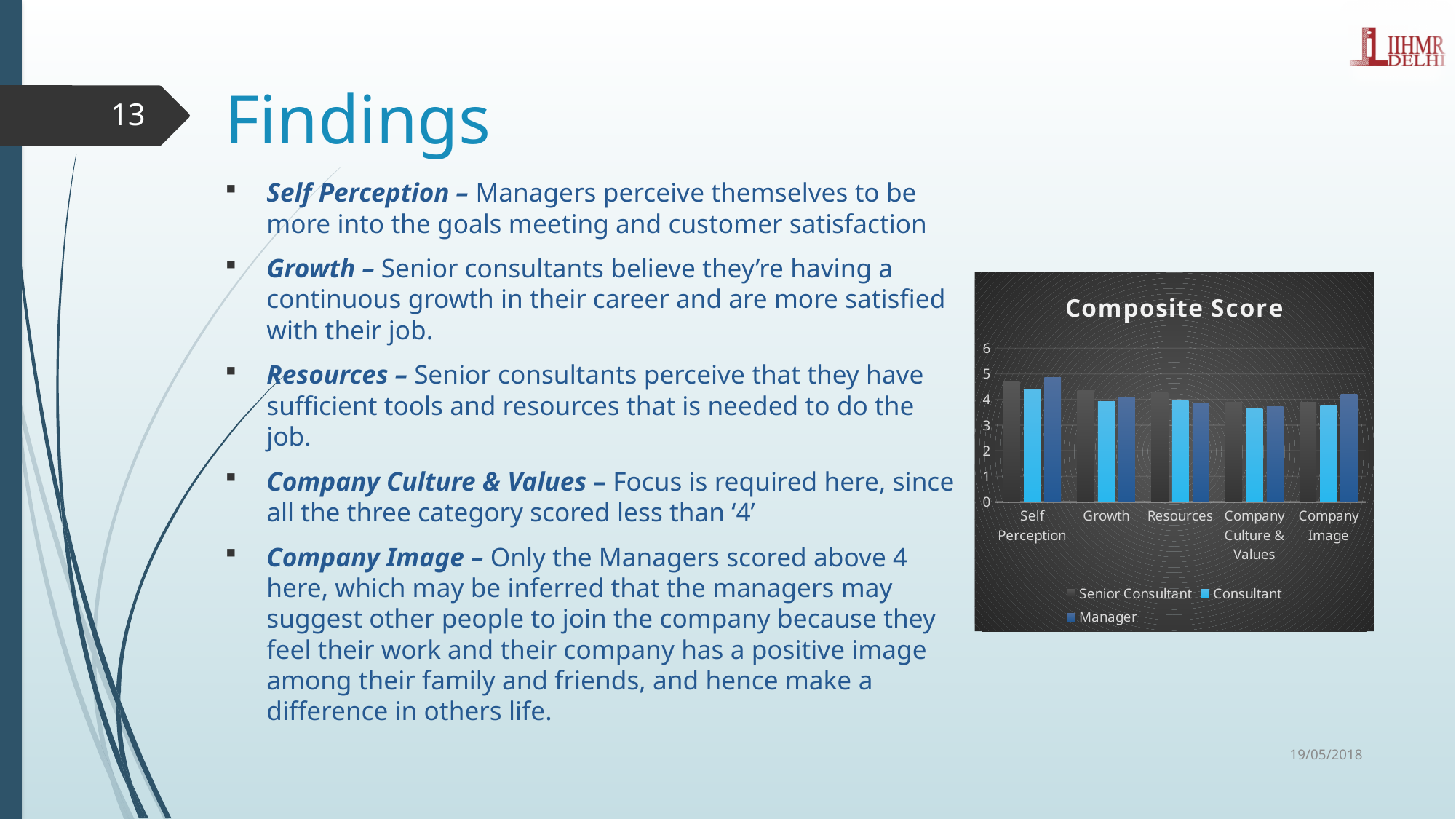
How many categories are shown on the x axis of the Composite Score chart? 5 What is the title of the chart on the slide? Composite Score How many series does the legend of the Composite Score chart list? 3 In the Composite Score chart, is the Consultant value for Company Culture & Values greater or less than 4? less In the Composite Score chart, is the Manager value for Self Perception greater or less than 4? greater What type of chart is shown on the slide? bar chart Which series are listed in the legend of the Composite Score chart? Senior Consultant, Consultant, Manager In the Composite Score chart, for Company Image, which is larger: the Manager value or the Consultant value? Manager In the Composite Score chart, which is larger for the Manager series: Self Perception or Company Culture & Values? Self Perception In the Composite Score chart, for which category is the Manager score highest? Self Perception In the Composite Score chart, is the Manager value for Company Culture & Values greater or less than 4? less